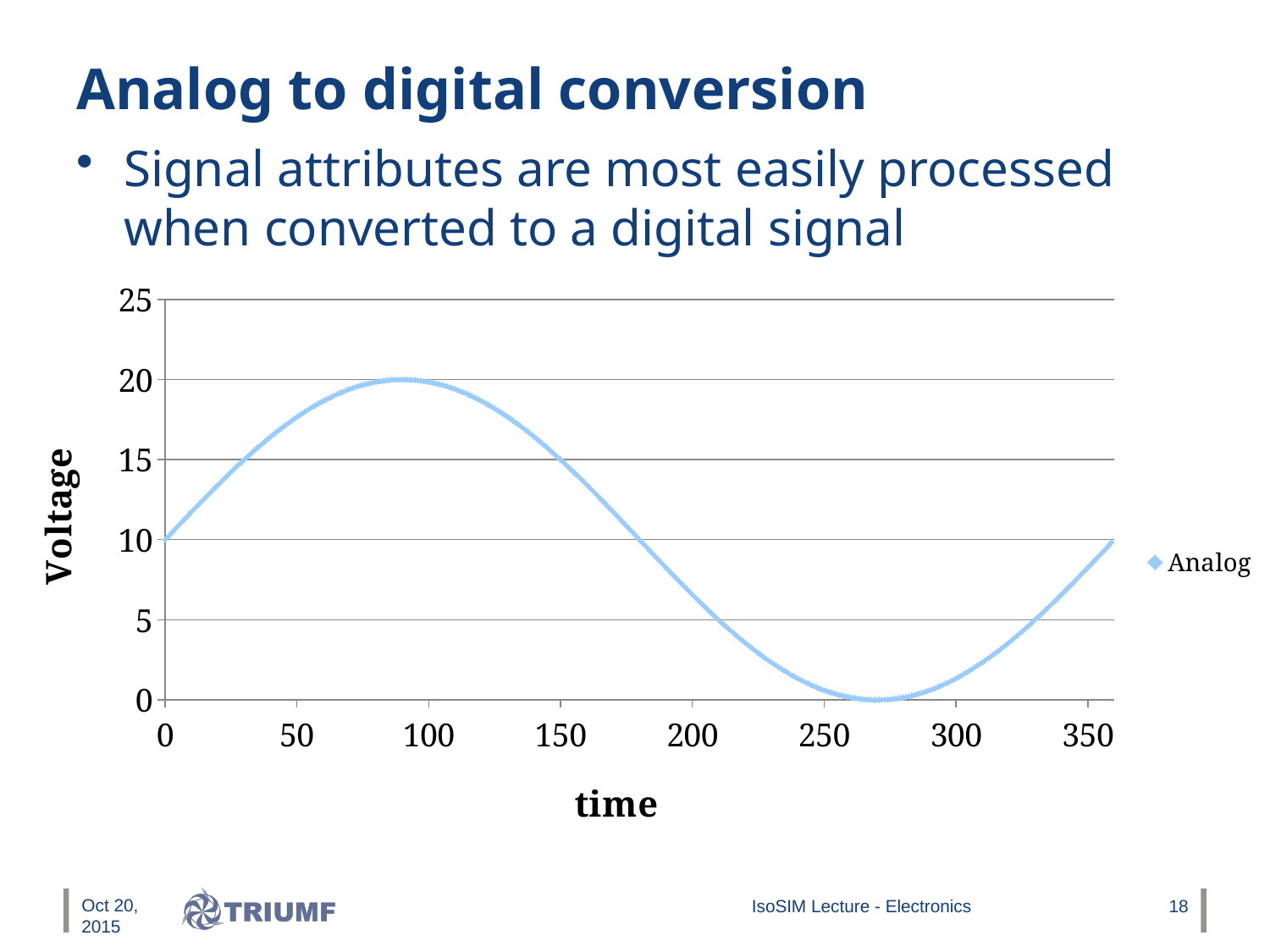
What is the lowest voltage reached by the Analog curve? 0 What is the name of the series shown in the legend? Analog What is the highest voltage reached by the Analog curve? 20 Does the voltage rise or fall between time 100 and time 250? fall Is the voltage at time 250 greater or less than 5? less Which is larger, the voltage at time 100 or the voltage at time 200? time 100 Is the voltage at time 50 greater or less than 15? greater What kind of chart is shown on the slide? line chart What is the voltage of the Analog signal at time 0? 10 Does the voltage rise or fall between time 0 and time 90? rise How many series does the legend list? 1 What is the label of the vertical axis? Voltage